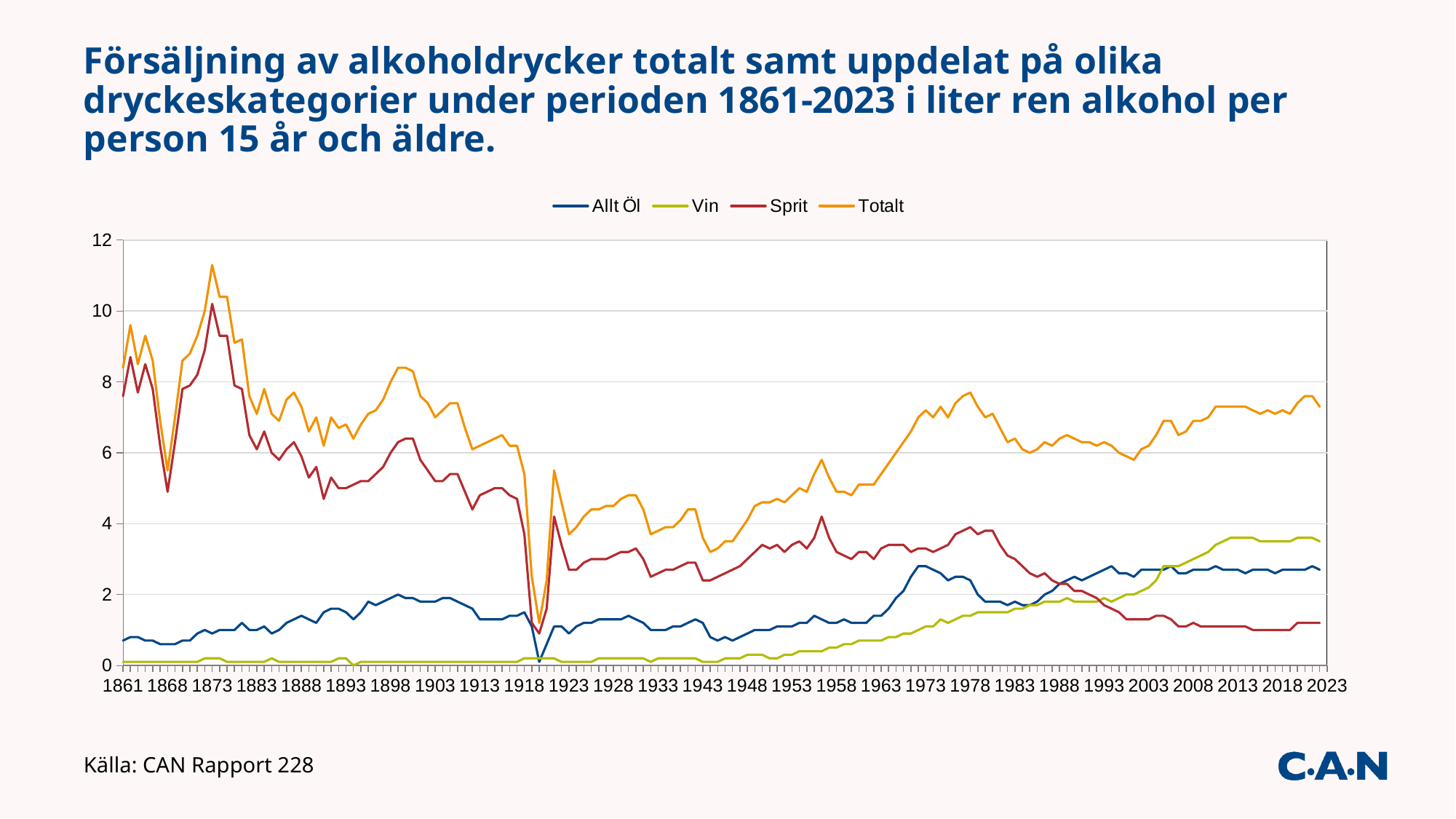
Is the value for Allt Öl in 1861 greater or less than 2? less What kind of chart is shown on the slide? Line chart What source is cited below the chart? Källa: CAN Rapport 228 Is the value for Sprit in 2023 greater or less than 2? less Which series are listed in the legend? Allt Öl, Vin, Sprit, Totalt How many series does the legend list? 4 Does the Sprit series rise or fall from 1978 to 2023? Fall In 1861, which is higher, Sprit or Allt Öl? Sprit In 2023, which is higher, Vin or Sprit? Vin Is the value for Vin in 2023 greater or less than 3? greater